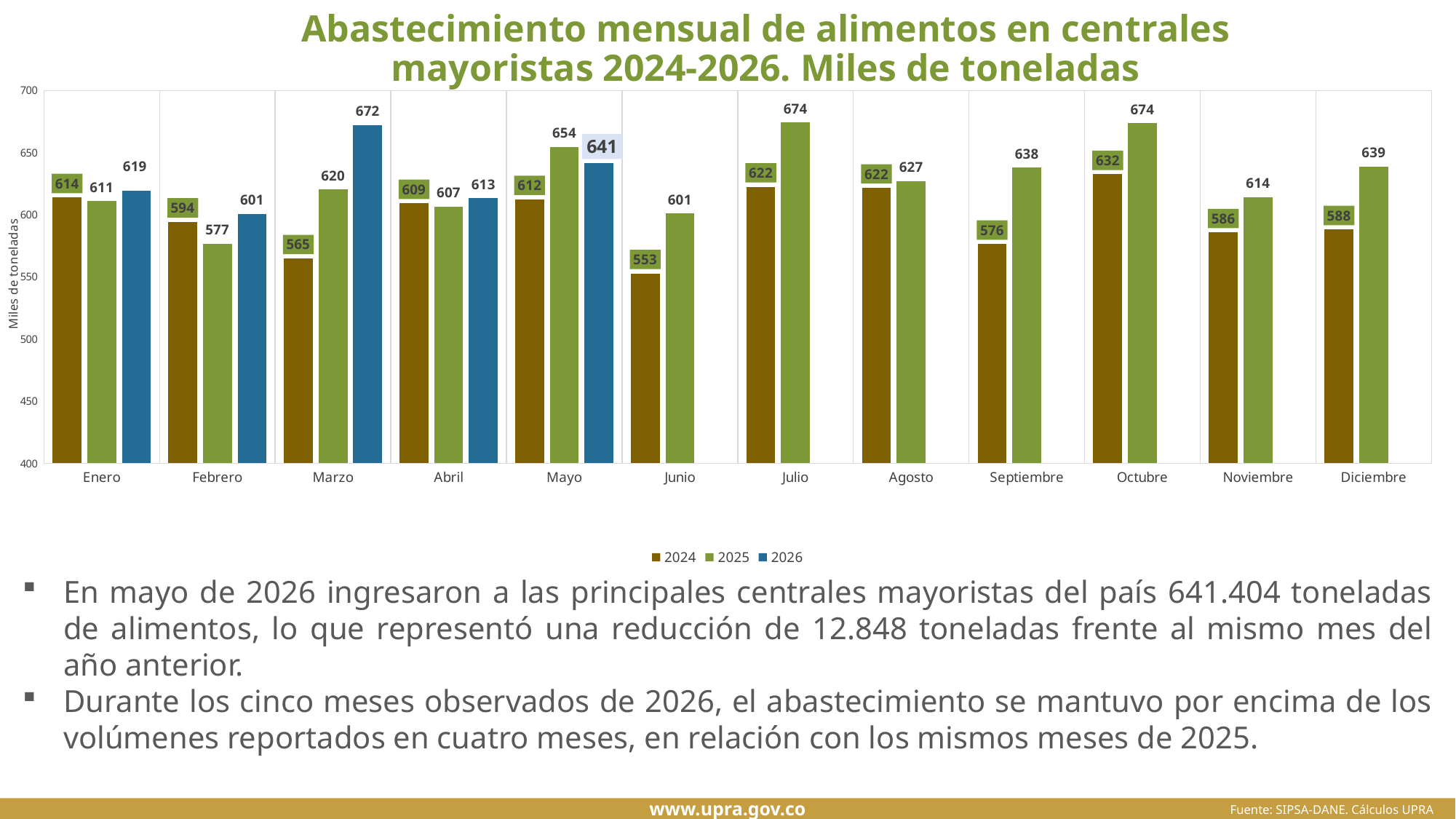
What is the value for 2026 in Marzo? 672 What is the difference between the 2025 and 2026 values in Mayo? 13 In Febrero, which is larger: the 2024 value or the 2025 value? 2024 What is the value for 2025 in Mayo? 654 What is the value for 2024 in Junio? 553 Which month has the highest value for the 2026 series? Marzo How many months are shown on the x axis? 12 How many series does the legend list? 3 What is the label of the vertical axis? Miles de toneladas Which month has the lowest value for the 2024 series? Junio What kind of chart is shown on the slide? Bar chart What is the difference between the 2026 and 2024 values in Marzo? 107